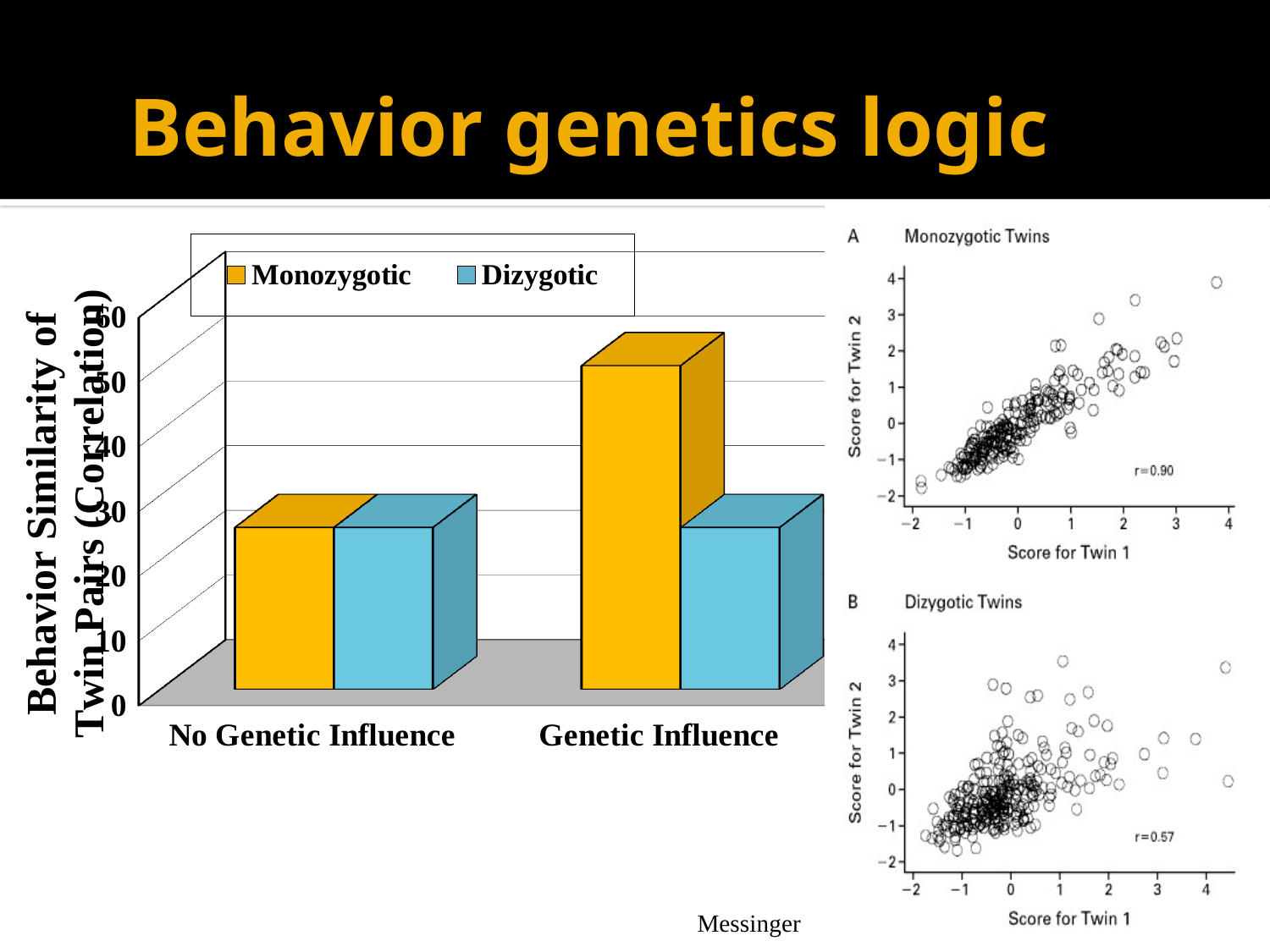
In the bar chart on the left, how many categories are shown on the x axis? 2 In the scatter plot titled Dizygotic Twins, what is the correlation r? r=0.57 In the bar chart on the left, under Genetic Influence, which is larger: the Monozygotic bar or the Dizygotic bar? Monozygotic In the bar chart on the left, which bar is the highest? Monozygotic, Genetic Influence In the scatter plot titled Monozygotic Twins, what is the correlation r? r=0.90 Which scatter plot shows the larger correlation, Monozygotic Twins or Dizygotic Twins? Monozygotic Twins What kind of chart is the chart on the left of the slide? bar chart In the bar chart on the left, which colour represents the Dizygotic series? blue What is the difference between the correlation in the Monozygotic Twins scatter plot and the Dizygotic Twins scatter plot? 0.33 In the bar chart on the left, is the Dizygotic value for Genetic Influence greater or less than 40? less In the bar chart on the left, is the Monozygotic value for Genetic Influence greater or less than 40? greater In the bar chart on the left, how many series does the legend list? 2